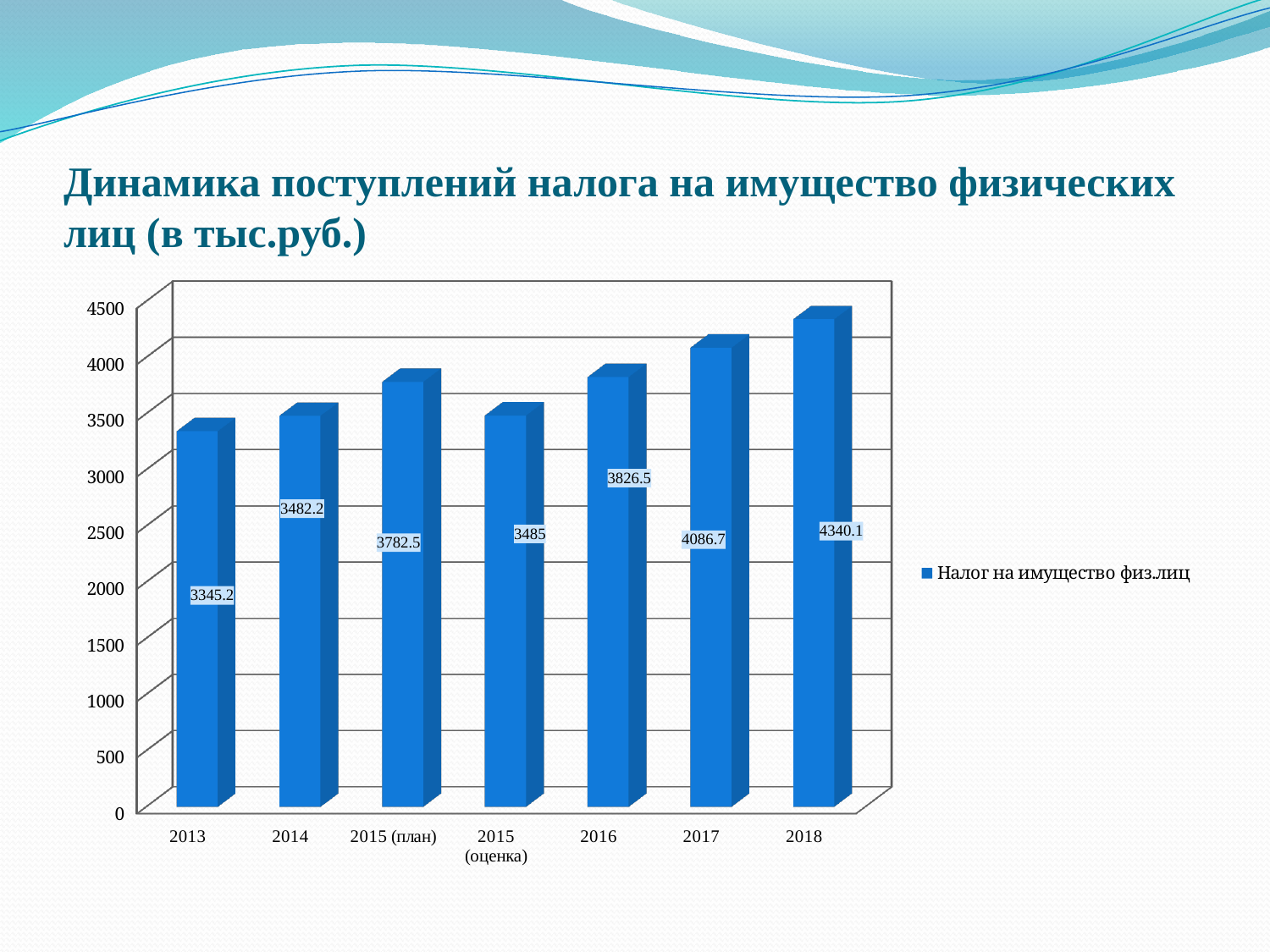
Which category has the lowest value? 2013 How many categories are shown on the x axis? 7 What is the value for 2015 (оценка)? 3485 What kind of chart is shown on the slide? bar chart What is the value for 2017? 4086.7 What is the difference between the values for 2018 and 2013? 994.9 What is the value for 2015 (план)? 3782.5 What is the difference between the values for 2015 (план) and 2015 (оценка)? 297.5 What is the value for 2013? 3345.2 Which category has the highest value? 2018 Which is larger, the value for 2017 or the value for 2014? 2017 What series name does the legend show? Налог на имущество физ.лиц